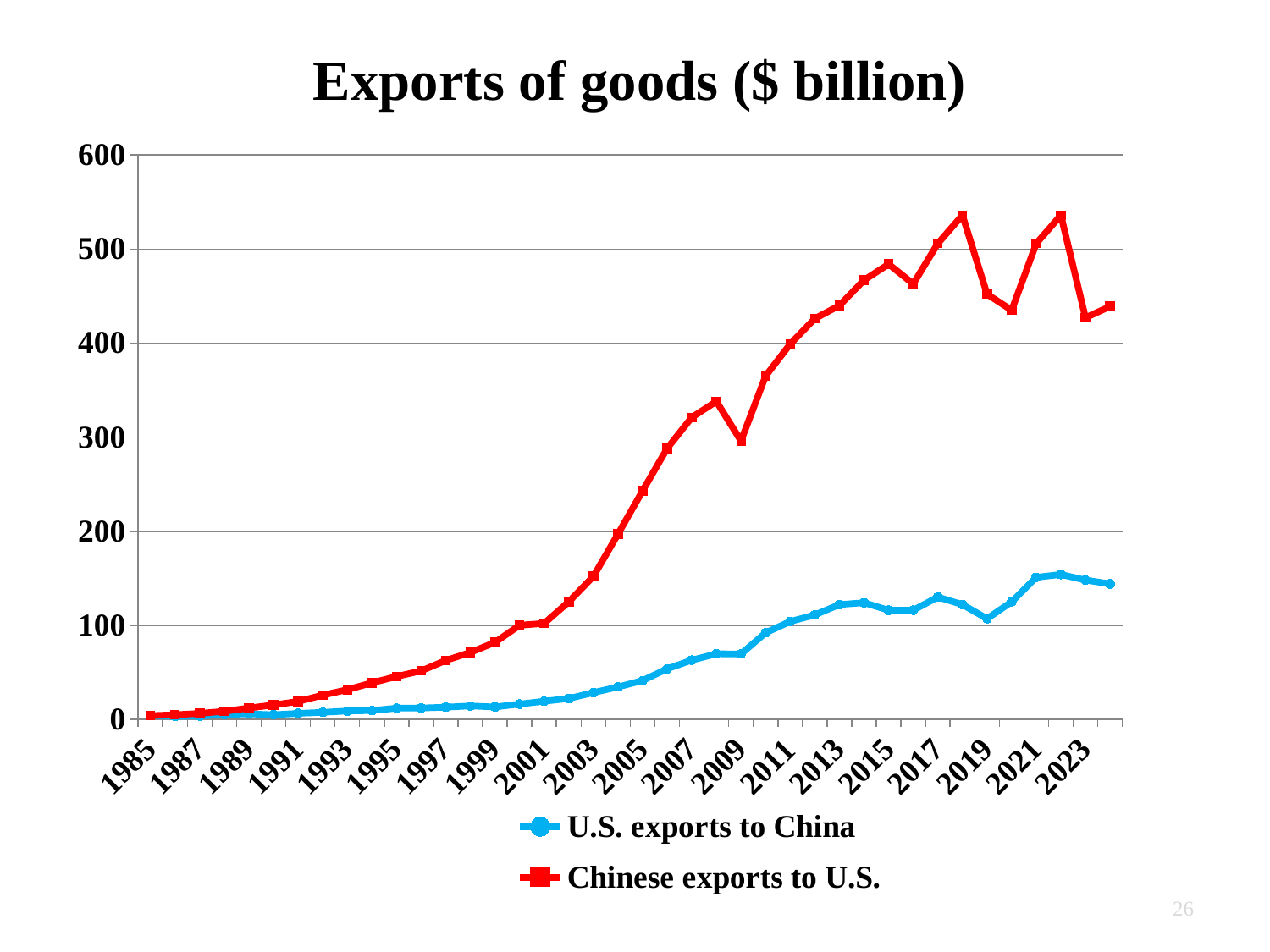
Is the value for Chinese exports to U.S. in 2013 greater or less than 400? greater In 2018, which series has the larger value: U.S. exports to China or Chinese exports to U.S.? Chinese exports to U.S. What is the title of the chart? Exports of goods ($ billion) Is the value for Chinese exports to U.S. in 2018 greater or less than 500? greater For Chinese exports to U.S., which year has the larger value: 2018 or 2019? 2018 Is the value for U.S. exports to China in 2007 greater or less than 100? less What kind of chart is shown on the slide? line chart Which colour is used for the Chinese exports to U.S. series? red How many series does the legend list? 2 Do the values for U.S. exports to China rise or fall from 1985 to 2013? rise